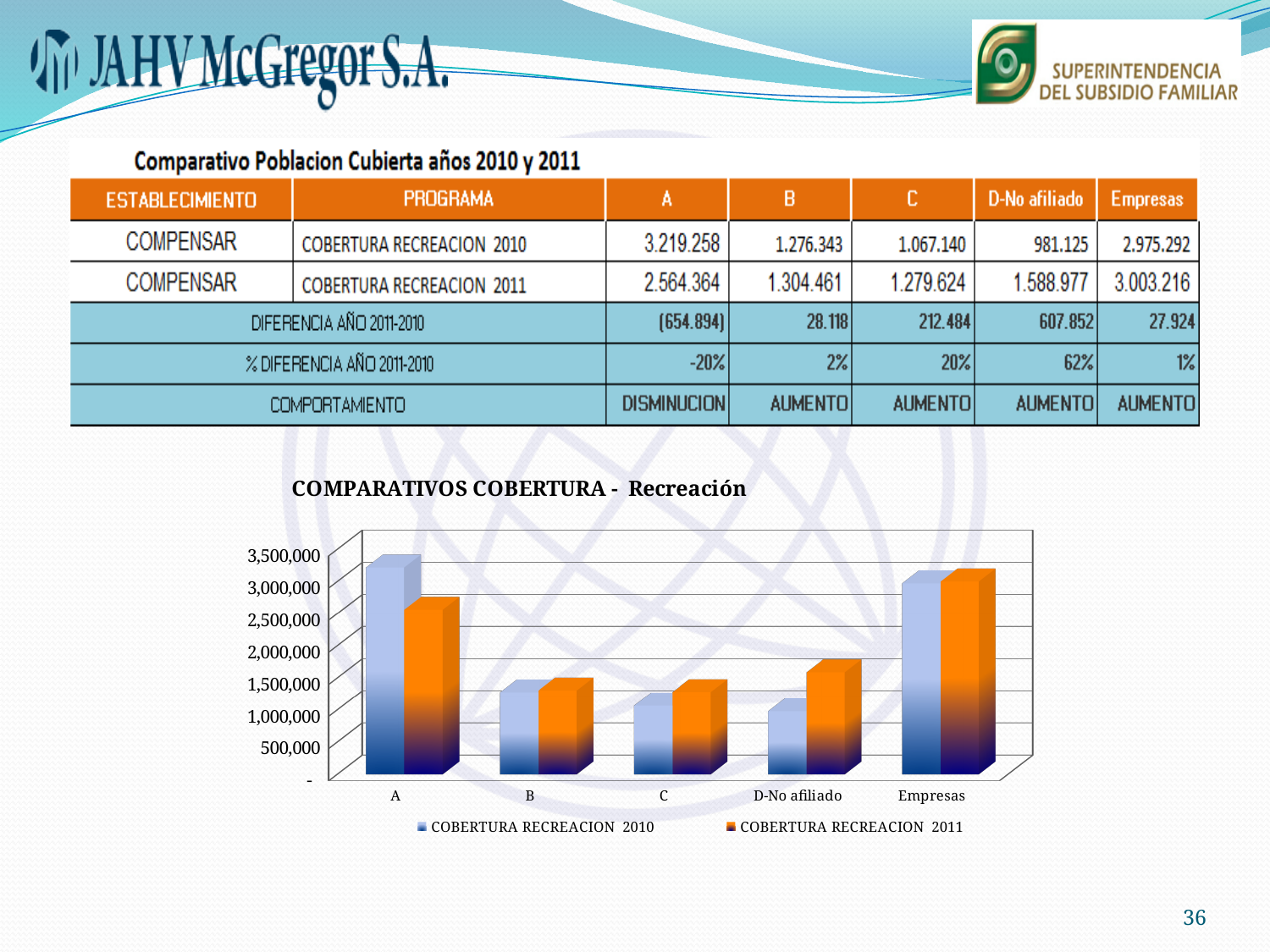
Which category has the highest value for COBERTURA RECREACION 2010? A Is the value for A in COBERTURA RECREACION 2010 greater or less than 3,000,000? greater Which category has the lowest value for COBERTURA RECREACION 2010? D-No afiliado What kind of chart is shown on the slide? bar chart For category A, which series is larger: COBERTURA RECREACION 2010 or COBERTURA RECREACION 2011? COBERTURA RECREACION 2010 How many series does the chart legend list? 2 Is the value for C in COBERTURA RECREACION 2010 greater or less than 1,500,000? less Which category has the highest value for COBERTURA RECREACION 2011? Empresas What is the title of the chart? COMPARATIVOS COBERTURA - Recreación According to the table on the slide, what is the value for A in COBERTURA RECREACION 2011? 2.564.364 For category D-No afiliado, which series is larger: COBERTURA RECREACION 2010 or COBERTURA RECREACION 2011? COBERTURA RECREACION 2011 How many categories are shown on the x axis of the chart? 5